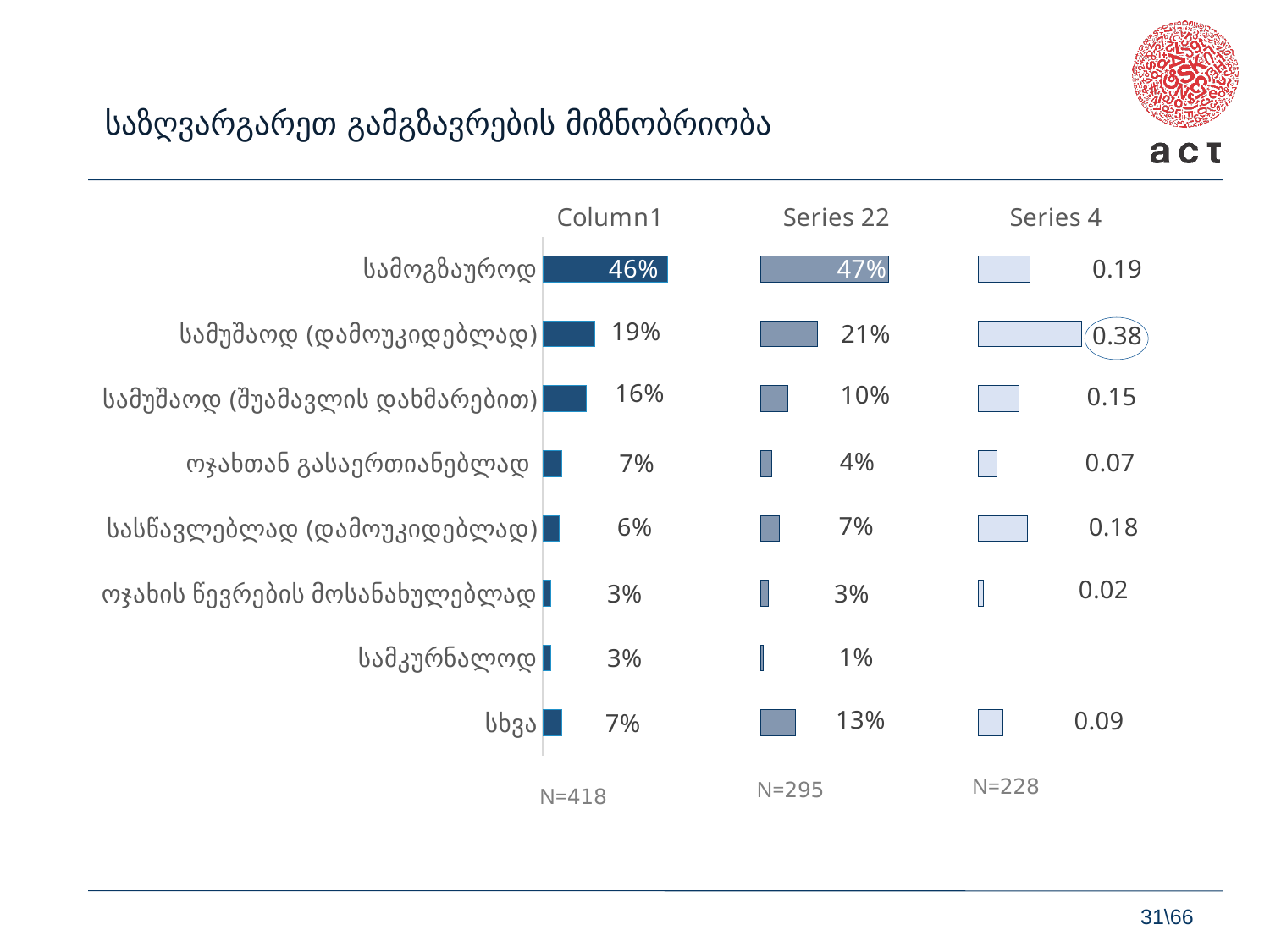
In the Series 4 chart, what is the difference between the values for სამუშაოდ (დამოუკიდებლად) and სამოგზაუროდ? 0.19 In the Series 4 chart, what is the value for სასწავლებლად (დამოუკიდებლად)? 0.18 What type of chart is used on this slide? Bar chart In the Series 22 chart, which is larger: the value for სხვა or the value for სამუშაოდ (შუამავლის დახმარებით)? სხვა In the Column1 chart, what is the difference between the values for სამოგზაუროდ and სამუშაოდ (დამოუკიდებლად)? 27% How many categories are listed in the Column1 chart? 8 In the Series 22 chart, which category has the lowest value? სამკურნალოდ In the Series 4 chart, which category has the highest value? სამუშაოდ (დამოუკიდებლად) What is the sample size (N) shown under the Series 22 chart? N=295 In the Column1 chart, which category has the highest value? სამოგზაუროდ In the Column1 chart, what is the value for სამოგზაუროდ? 46% In the Series 22 chart, what is the value for სამუშაოდ (დამოუკიდებლად)? 21%